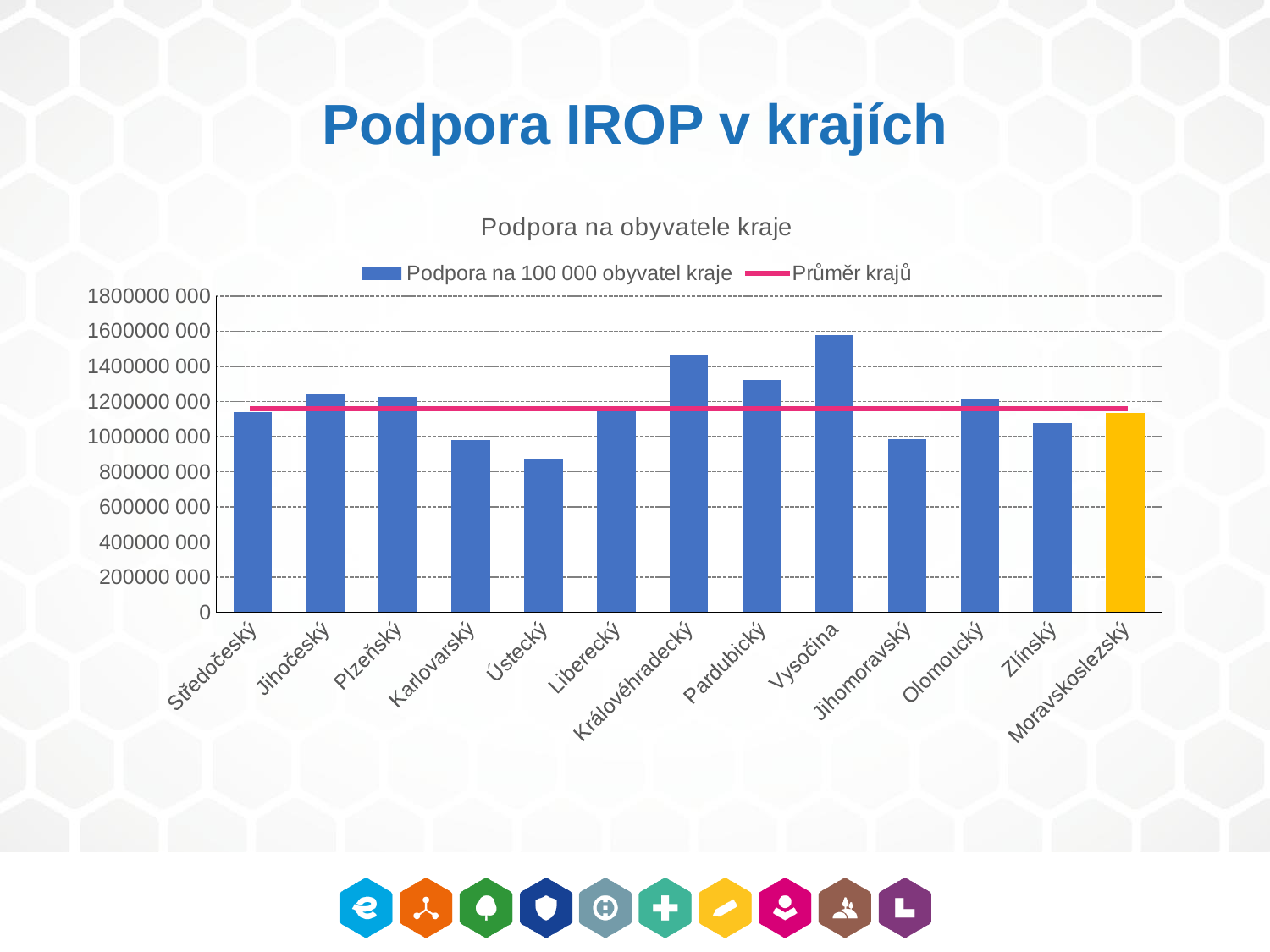
Which region's bar is shown in a different colour (yellow) from the others? Moravskoslezský Which region has the highest value for Podpora na 100 000 obyvatel kraje? Vysočina Is the value for Ústecký greater or less than 1000000 000? less Which region has the lowest value for Podpora na 100 000 obyvatel kraje? Ústecký What is the title of the chart? Podpora na obyvatele kraje Is the value for Vysočina greater or less than 1400000 000? greater Which has a larger value, Královéhradecký or Vysočina? Vysočina How many series does the chart legend list? 2 What type of chart is shown on the slide? combination bar and line chart How many regions (categories) are shown on the x axis? 13 Is the value for Pardubický greater or less than 1200000 000? greater Which has a larger value, Ústecký or Karlovarský? Karlovarský